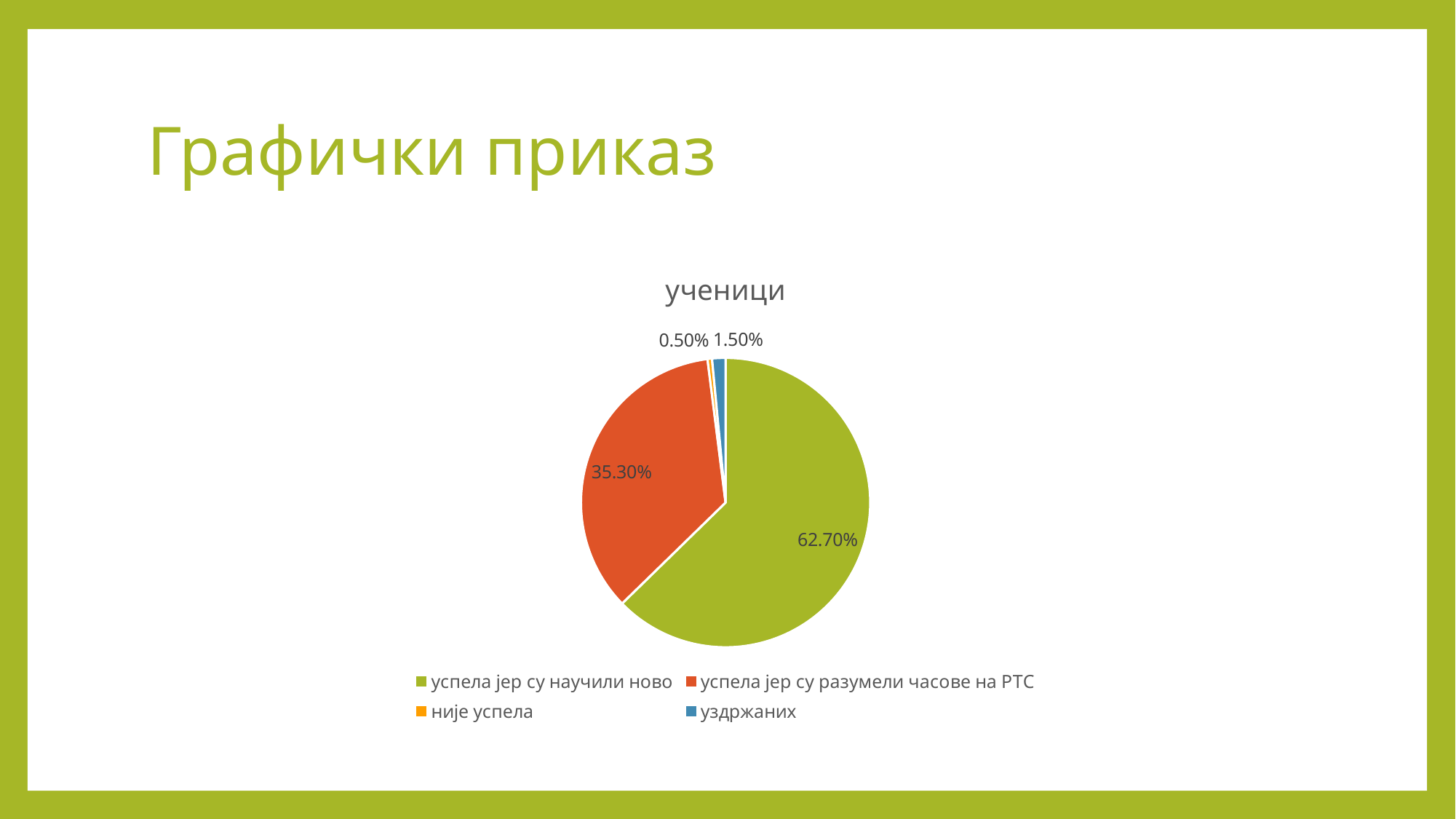
What share of the pie is 'уздржаних'? 1.50% Which category has the smallest slice? није успела What share of the pie is 'успела јер су научили ново'? 62.70% What share of the pie is 'није успела'? 0.50% What kind of chart is shown on the slide? pie chart Which is larger, the share for 'уздржаних' or the share for 'није успела'? уздржаних What is the difference between the shares of 'успела јер су научили ново' and 'успела јер су разумели часове на РТС'? 27.40% What is the title of the chart? ученици Which category has the largest slice? успела јер су научили ново How many entries does the legend list? 4 How many slices does the pie chart have? 4